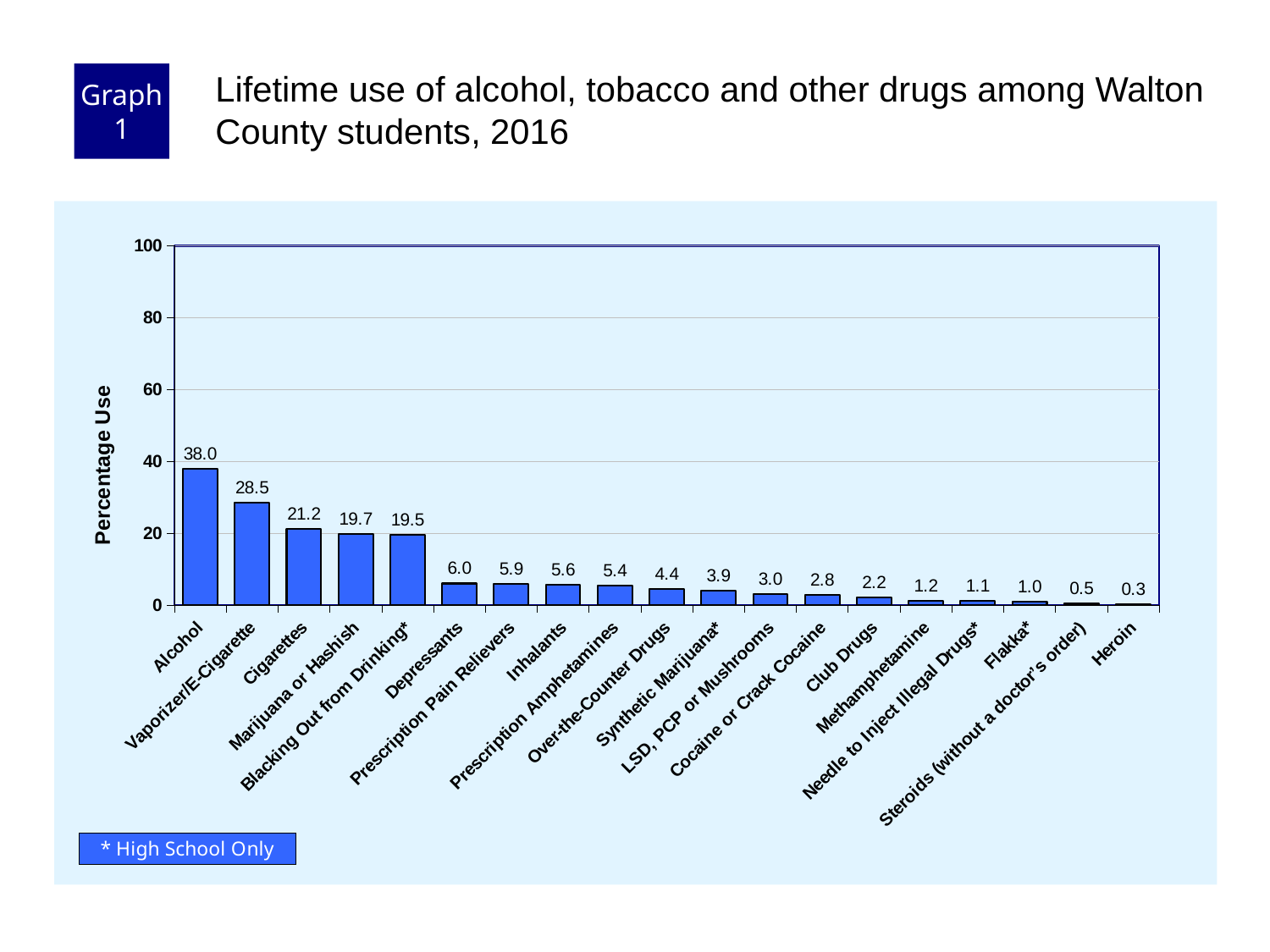
What is the percentage use for Marijuana or Hashish? 19.7 Which category has the highest percentage use? Alcohol What is the percentage use for Heroin? 0.3 Is the value for Vaporizer/E-Cigarette greater or less than 20? greater What is the difference in percentage use between Alcohol and Cigarettes? 16.8 What is the label of the y axis? Percentage Use Which has a higher percentage use, Depressants or Inhalants? Depressants What is the percentage use for Vaporizer/E-Cigarette? 28.5 Which category has the lowest percentage use? Heroin How many categories are shown on the x axis? 19 What kind of chart is shown on the slide? Bar chart What is the percentage use for Alcohol? 38.0